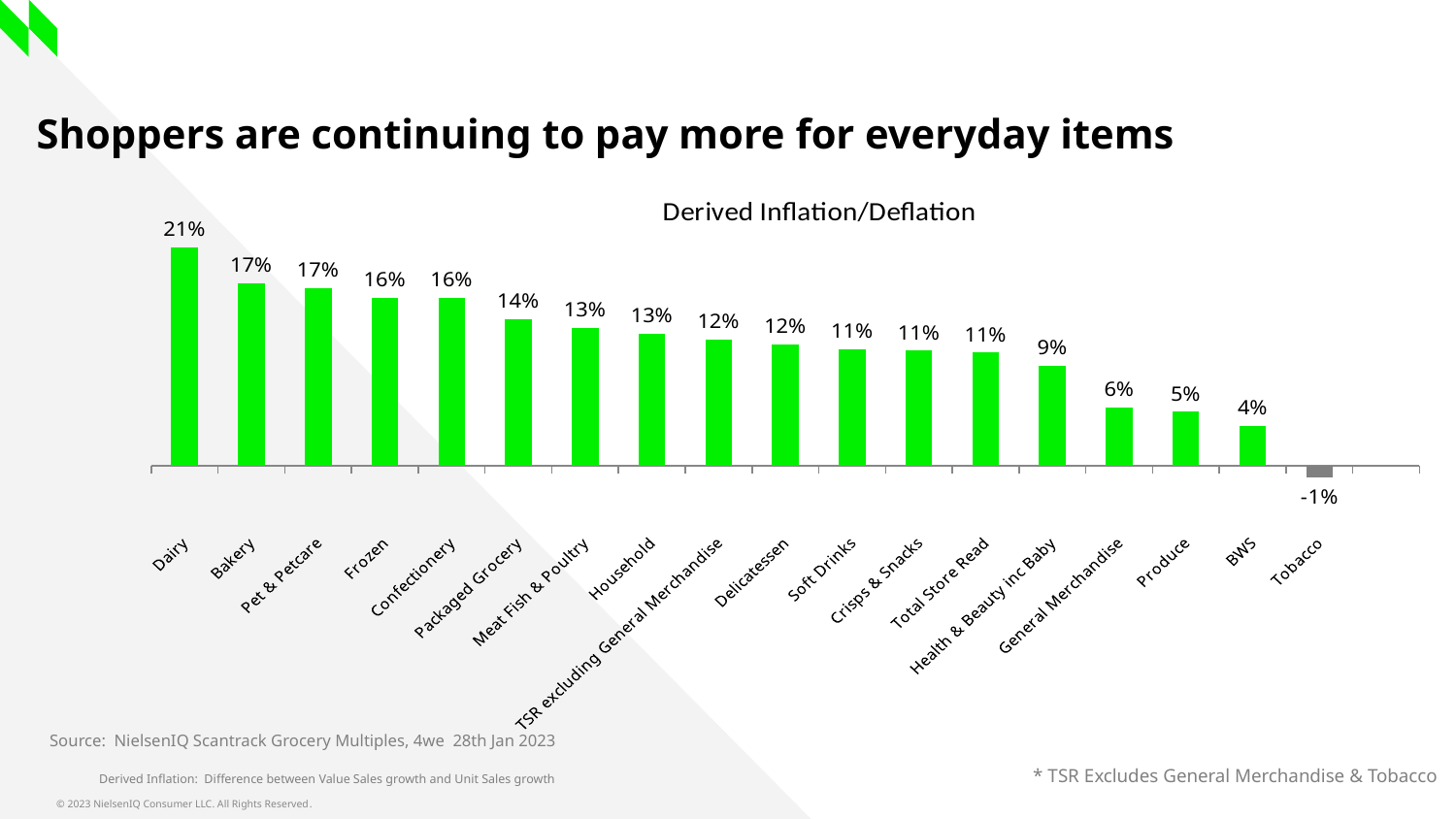
What is the derived inflation value for Dairy? 21% What is the difference between the values for Dairy and Bakery? 4% What is the difference between the values for Health & Beauty inc Baby and General Merchandise? 3% What is the title of the chart? Derived Inflation/Deflation How many categories are shown in the chart? 18 What type of chart is shown on the slide? Bar chart Which category has the highest derived inflation? Dairy What is the derived inflation value for Tobacco? -1% Which category has the lowest derived inflation? Tobacco Which has a higher derived inflation value, Frozen or Produce? Frozen What is the derived inflation value for Total Store Read? 11% Do the values generally rise or fall from left to right across the categories? Fall